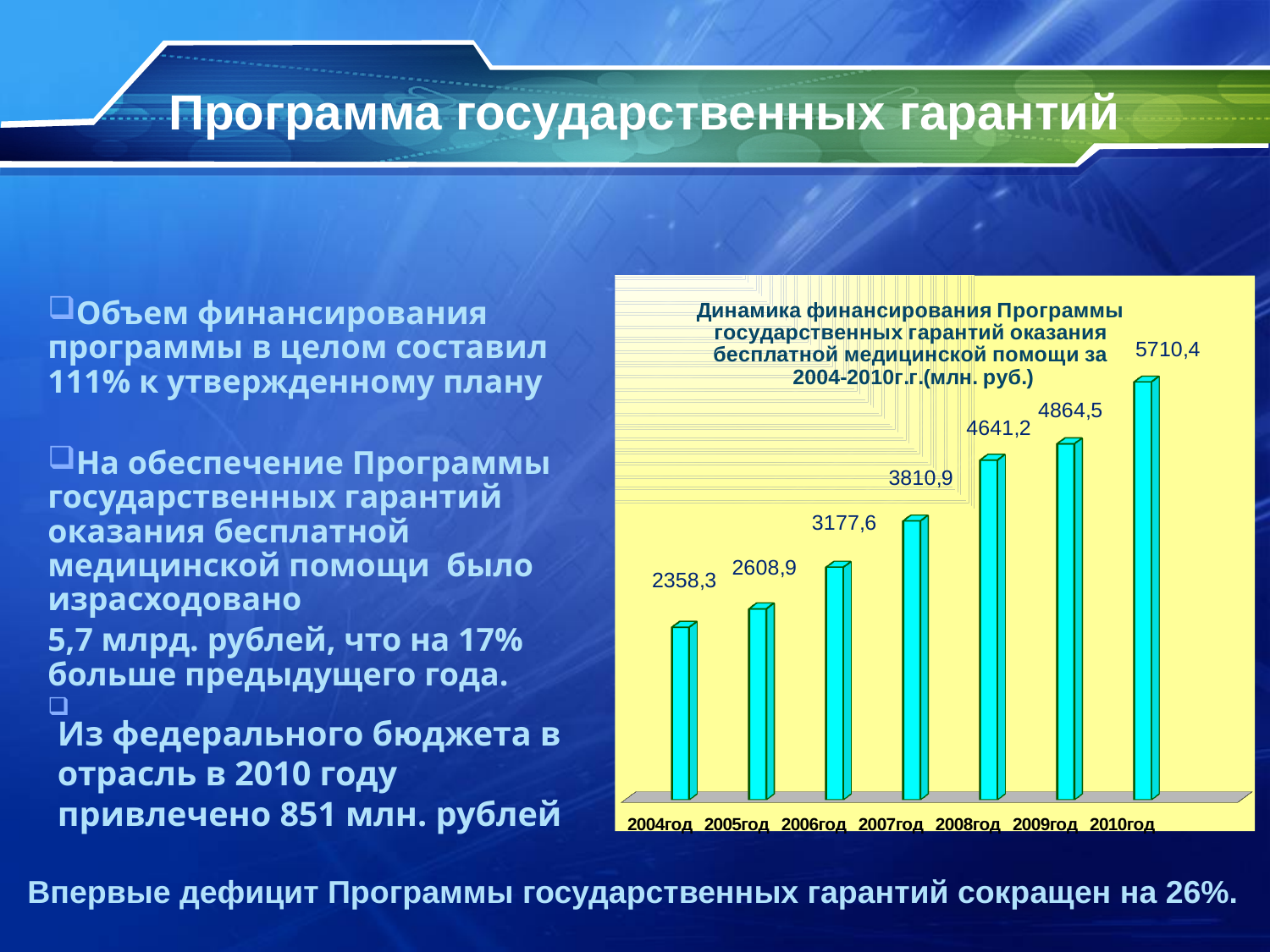
Which year has the lowest value? 2004год What is the difference between the values for 2010год and 2009год? 845,9 What is the value for 2007год? 3810,9 How many years (bars) are shown in the chart? 7 What type of chart is shown on the slide? bar chart What is the value for 2010год? 5710,4 Which year has the highest value? 2010год Which is larger, the value for 2008год or the value for 2006год? 2008год What is the value for 2004год? 2358,3 What is the value for 2009год? 4864,5 Do the values rise or fall from 2004год to 2010год? rise What is the difference between the values for 2007год and 2006год? 633,3